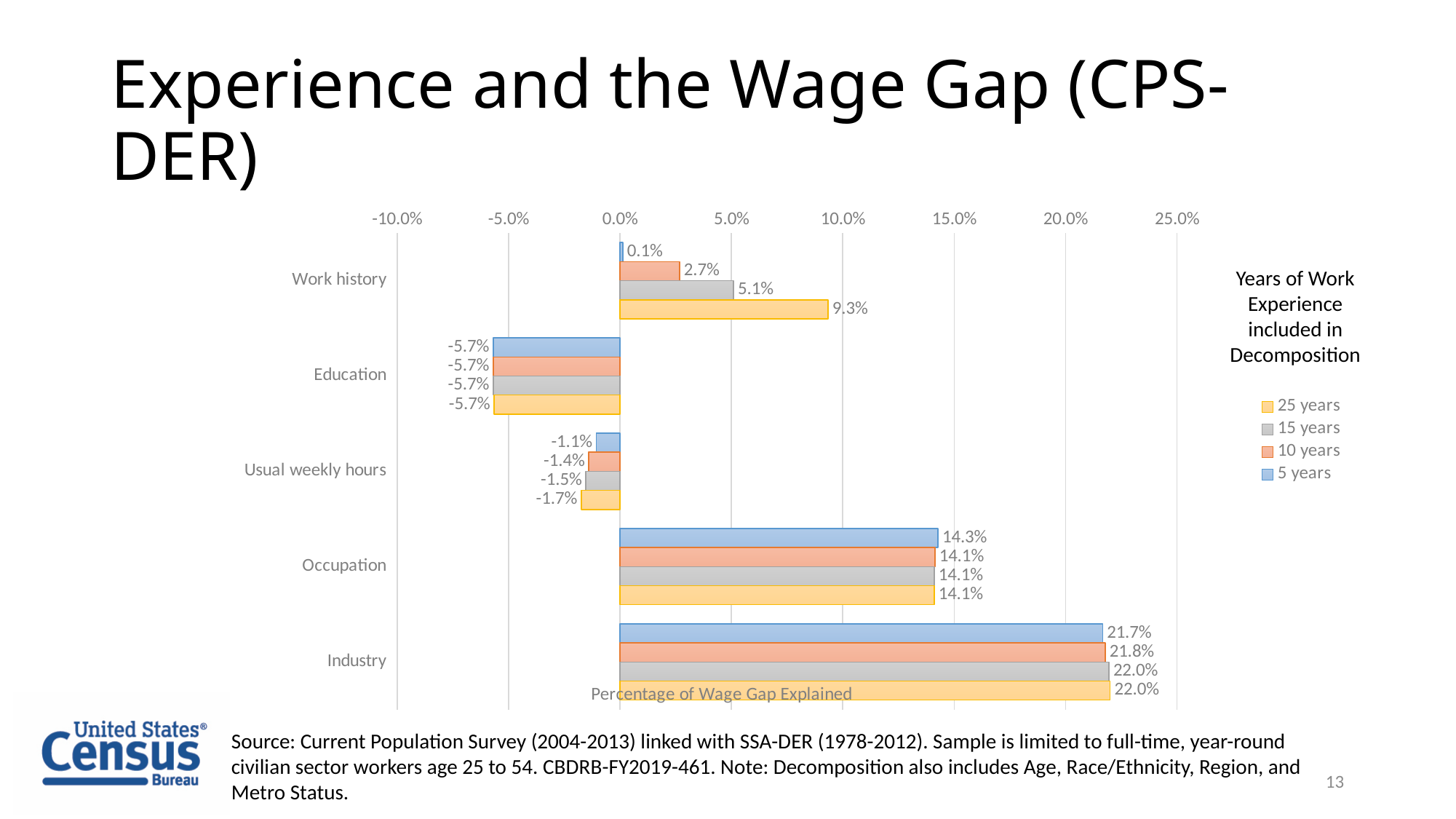
Which category has the lowest value in the 5 years series? Education What is the value for Education in the 10 years series? -5.7% What is the difference between the 25 years and 5 years values for Work history? 9.2% What kind of chart is shown on the slide? Bar chart What is the title of the legend? Years of Work Experience included in Decomposition How many categories are shown on the y axis? 5 How many series does the legend list? 4 What is the value for Work history in the 25 years series? 9.3% What is the value for Usual weekly hours in the 15 years series? -1.5% What is the value for Industry in the 5 years series? 21.7% For Work history, which is larger: the 15 years value or the 10 years value? 15 years Which category has the highest value in the 25 years series? Industry